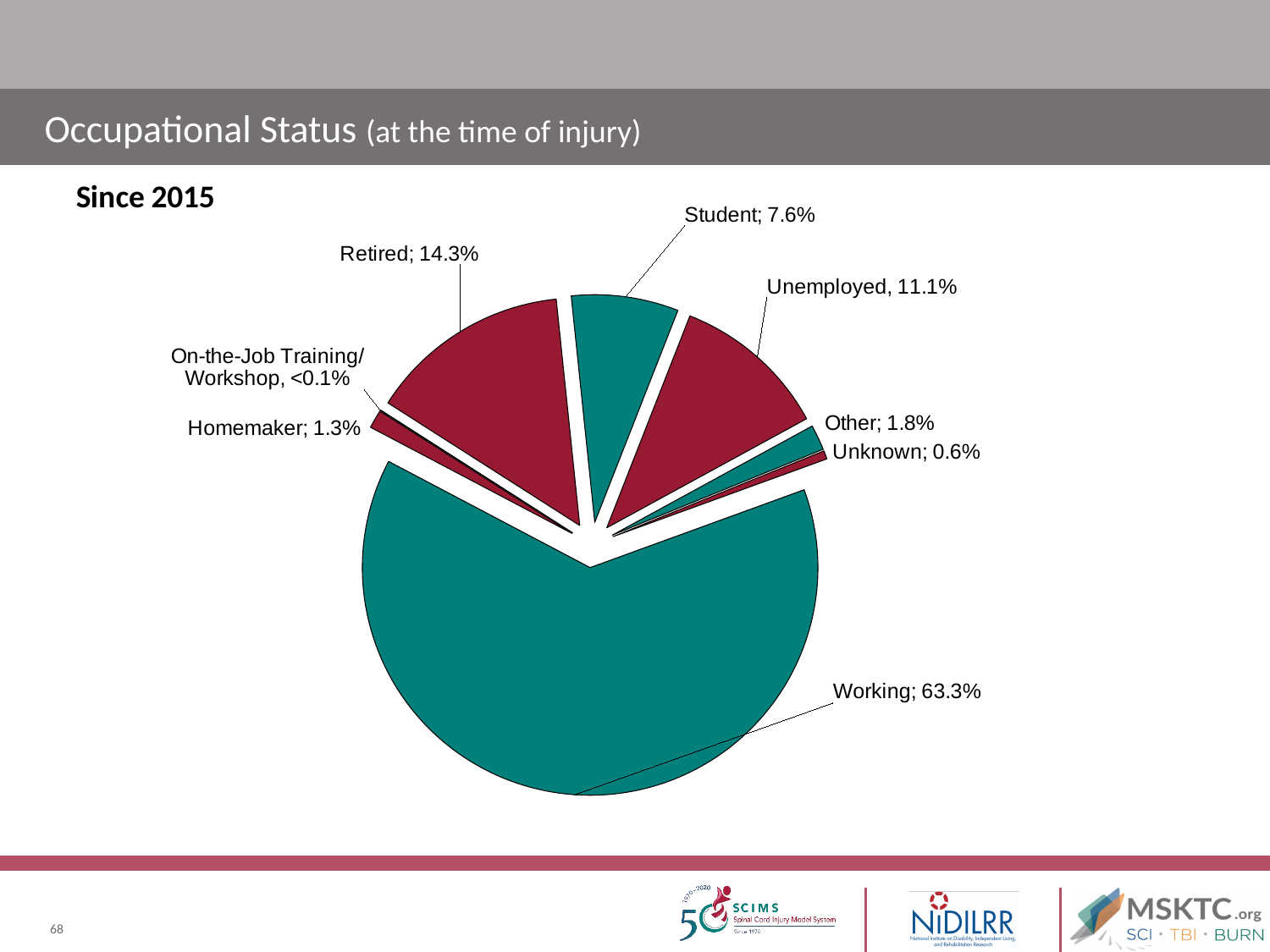
What is the difference in percentage points between Retired and Unemployed? 3.2 What percentage is shown for Homemaker? 1.3% What share of the pie is labelled Working? 63.3% Which category has the smallest slice of the pie? On-the-Job Training/Workshop Which category has the largest slice of the pie? Working What percentage is shown for Retired? 14.3% What percentage is shown for Unemployed? 11.1% How many categories are shown in the pie chart? 8 What percentage is shown for Student? 7.6% What kind of chart is shown on the slide? Pie chart Which is larger, the Other slice or the Unknown slice? Other What value is shown for On-the-Job Training/Workshop? <0.1%